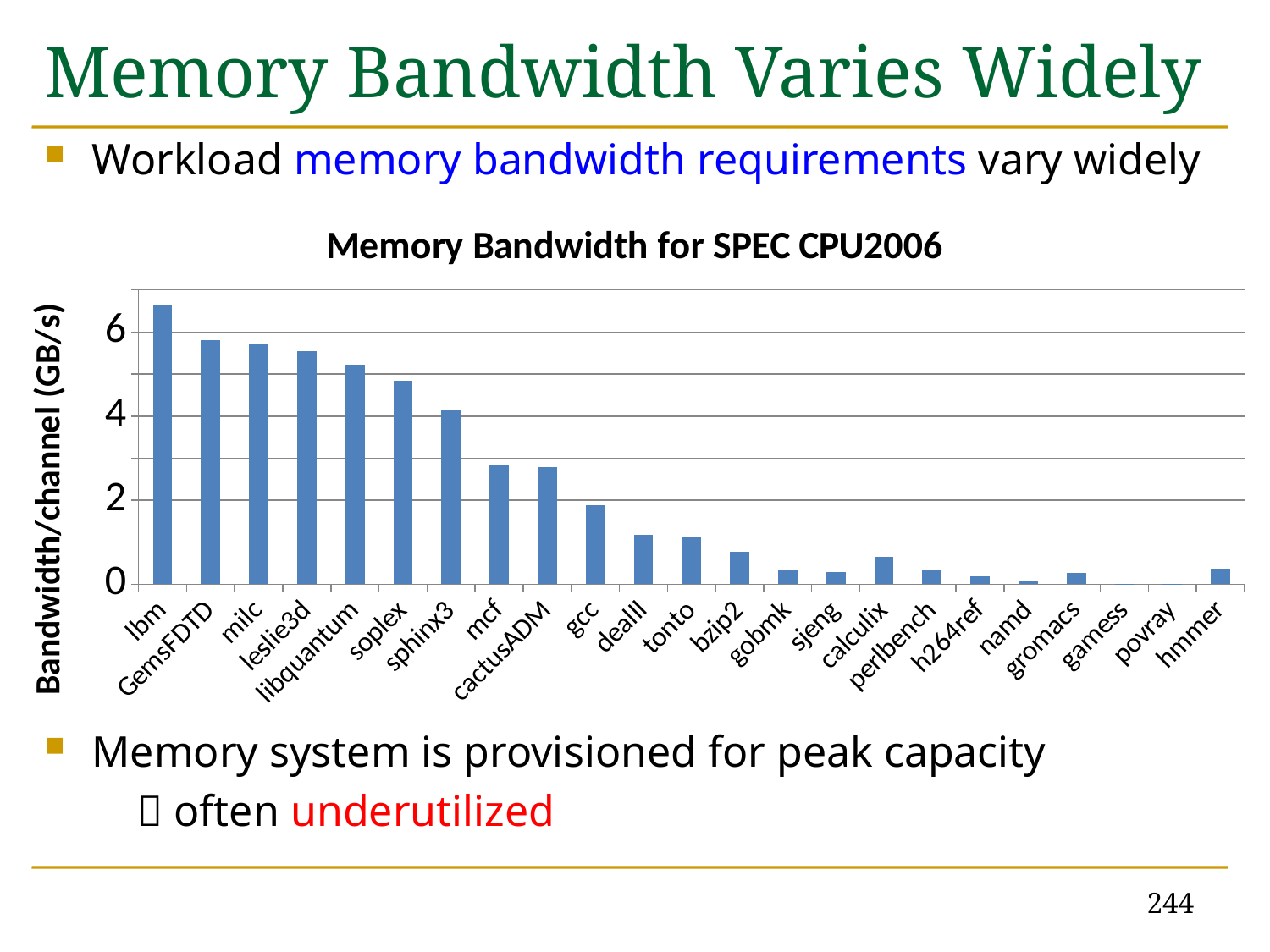
Which workload has the highest memory bandwidth? lbm Is the value for GemsFDTD greater or less than 6? less Is the value for mcf greater or less than 2? greater Is the value for lbm greater or less than 6? greater What is the title of the chart? Memory Bandwidth for SPEC CPU2006 What is the label of the vertical axis? Bandwidth/channel (GB/s) How many workloads (categories) are plotted on the x axis? 23 What kind of chart is shown on the slide? bar chart Do the bar values generally rise or fall from left to right along the x axis? fall Which has the larger memory bandwidth, calculix or gobmk? calculix